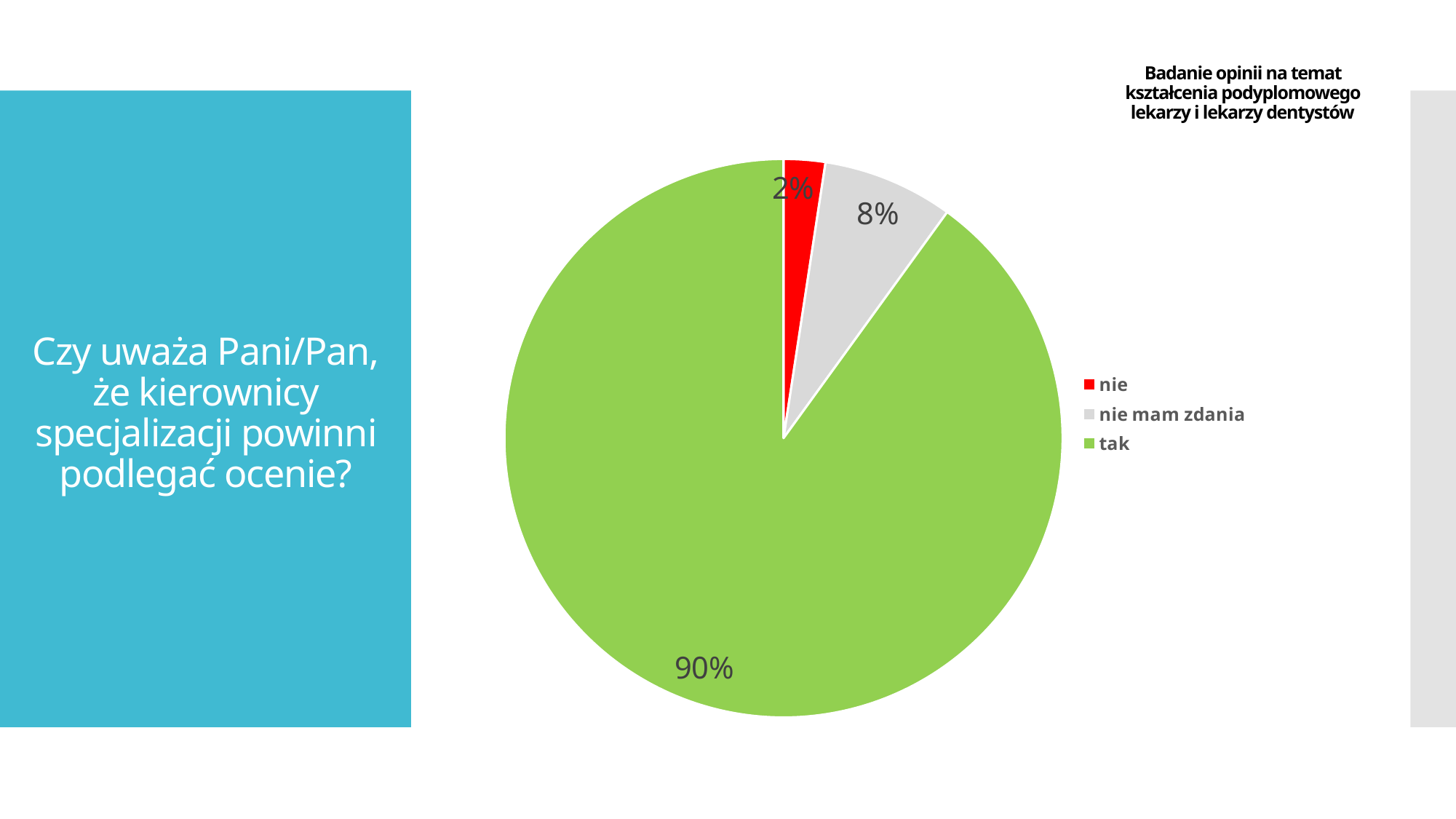
What colour is the "tak" slice? green What share of the pie does the "tak" slice represent? 90% What is the difference in percentage points between the "nie mam zdania" and "nie" slices? 6 What share of the pie does the "nie mam zdania" slice represent? 8% What is the difference in percentage points between the "tak" and "nie mam zdania" slices? 82 How many categories does the pie chart have? 3 Which category has the largest slice of the pie? tak What question does the pie chart answer, according to the text on the left of the slide? Czy uważa Pani/Pan, że kierownicy specjalizacji powinni podlegać ocenie? What kind of chart is shown on the slide? pie chart Which category has the smallest slice of the pie? nie Which slice is larger, "nie" or "nie mam zdania"? nie mam zdania What share of the pie does the "nie" slice represent? 2%